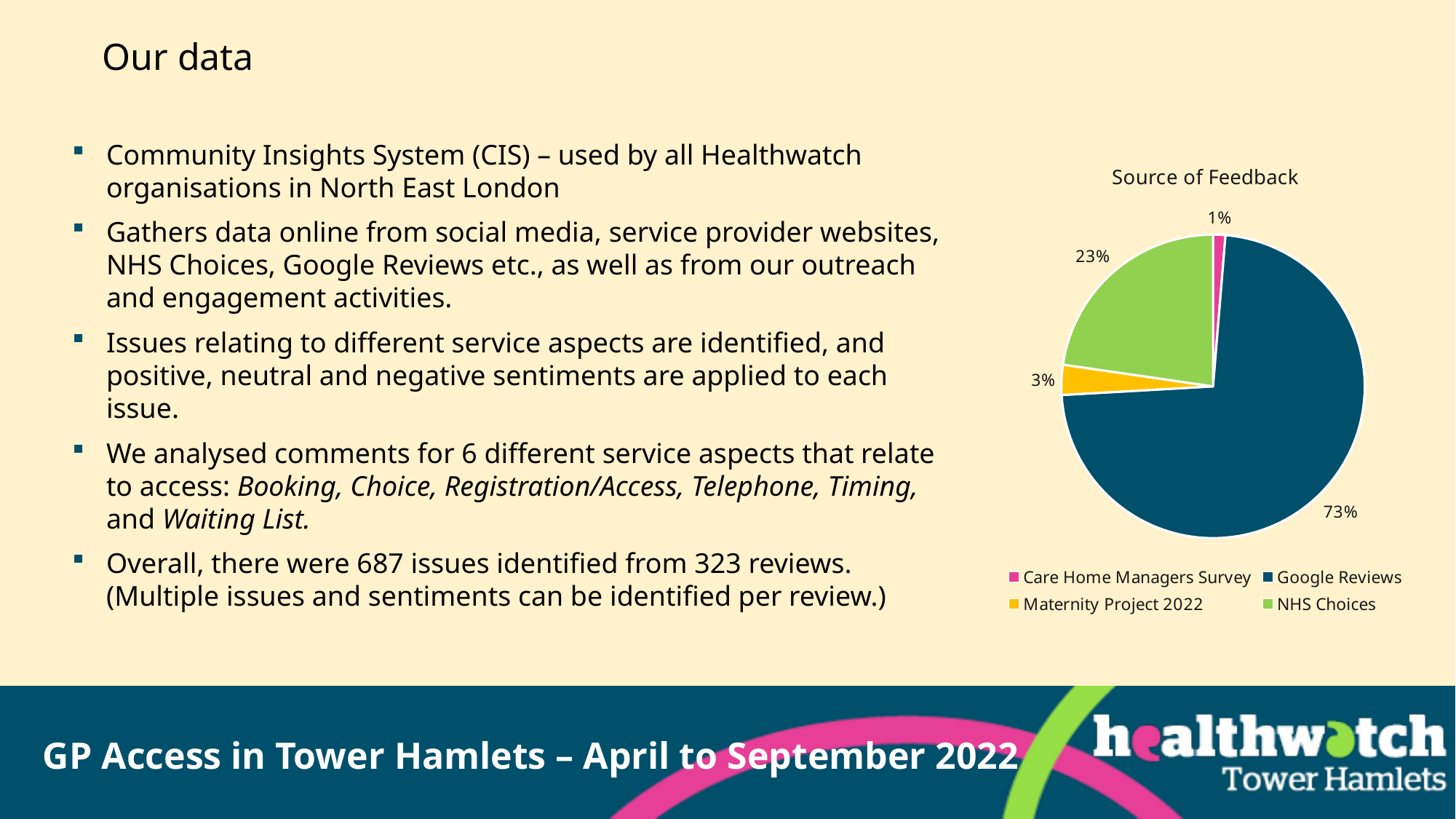
What share of feedback came from the Care Home Managers Survey? 1% Which source of feedback has the smallest share? Care Home Managers Survey Which has a larger share, NHS Choices or Maternity Project 2022? NHS Choices What is the title of the chart? Source of Feedback What share of feedback came from the Maternity Project 2022? 3% What colour is the Google Reviews slice? Dark blue What is the difference in percentage points between Google Reviews and NHS Choices? 50 What type of chart is shown on the slide? Pie chart What share of feedback came from Google Reviews? 73% How many sources of feedback are shown in the pie chart? 4 Which source of feedback has the largest share? Google Reviews